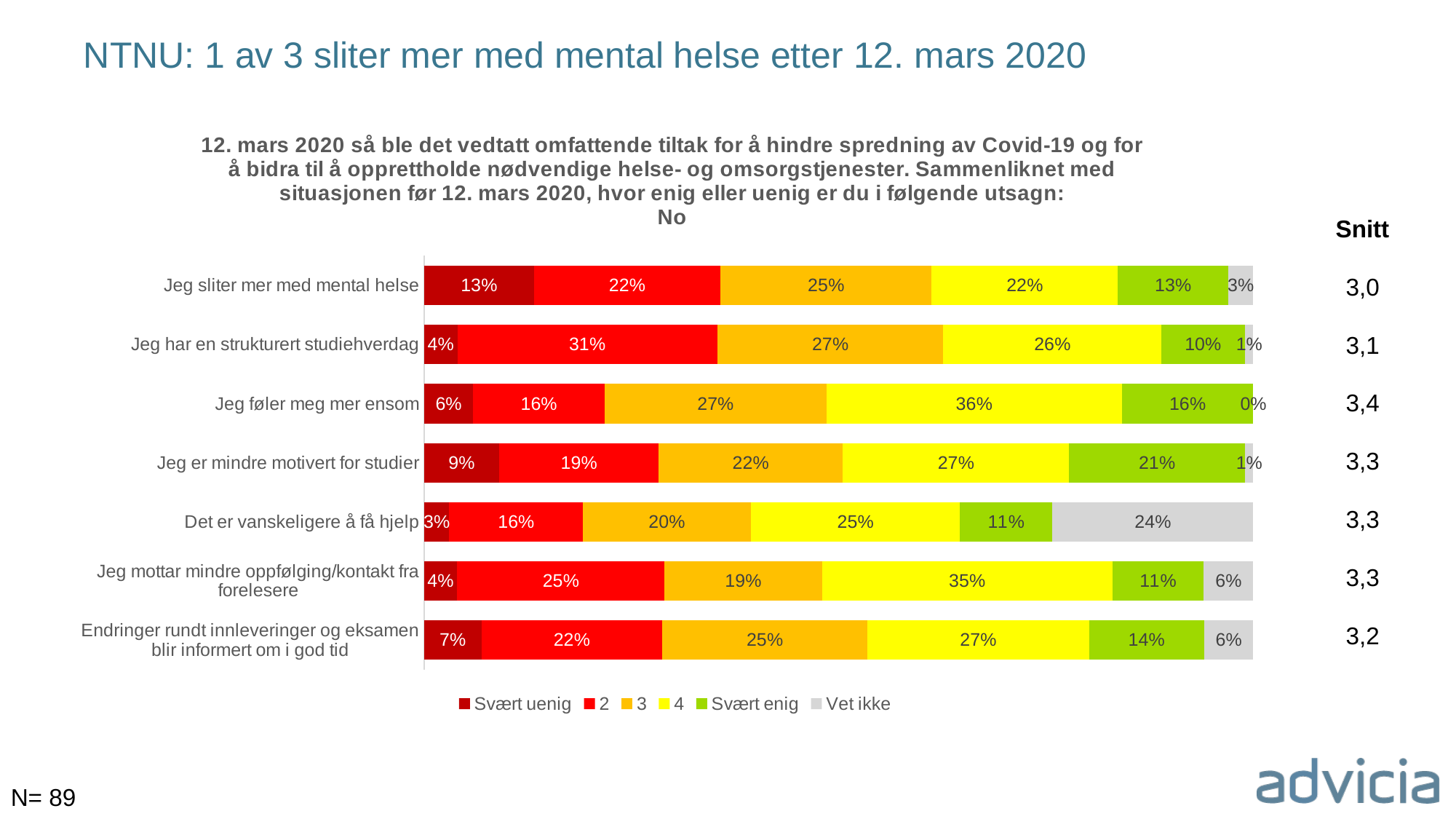
What is the 'Vet ikke' value for 'Det er vanskeligere å få hjelp'? 24% What is the 'Svært uenig' value for 'Jeg sliter mer med mental helse'? 13% Which statement has the highest 'Svært uenig' value? Jeg sliter mer med mental helse What is the 'Svært enig' value for 'Jeg er mindre motivert for studier'? 21% Which statement has the highest 'Vet ikke' value? Det er vanskeligere å få hjelp What is the difference between the '2' value for 'Jeg har en strukturert studiehverdag' and the '2' value for 'Jeg føler meg mer ensom'? 15% Which is larger: the '4' value for 'Jeg mottar mindre oppfølging/kontakt fra forelesere' or the '4' value for 'Jeg sliter mer med mental helse'? Jeg mottar mindre oppfølging/kontakt fra forelesere What kind of chart is shown on the slide? Stacked bar chart What colour represents the 'Svært enig' series in the legend? Green How many statements (categories) are plotted in the chart? 7 How many series does the legend list? 6 What is the '4' value for 'Jeg føler meg mer ensom'? 36%